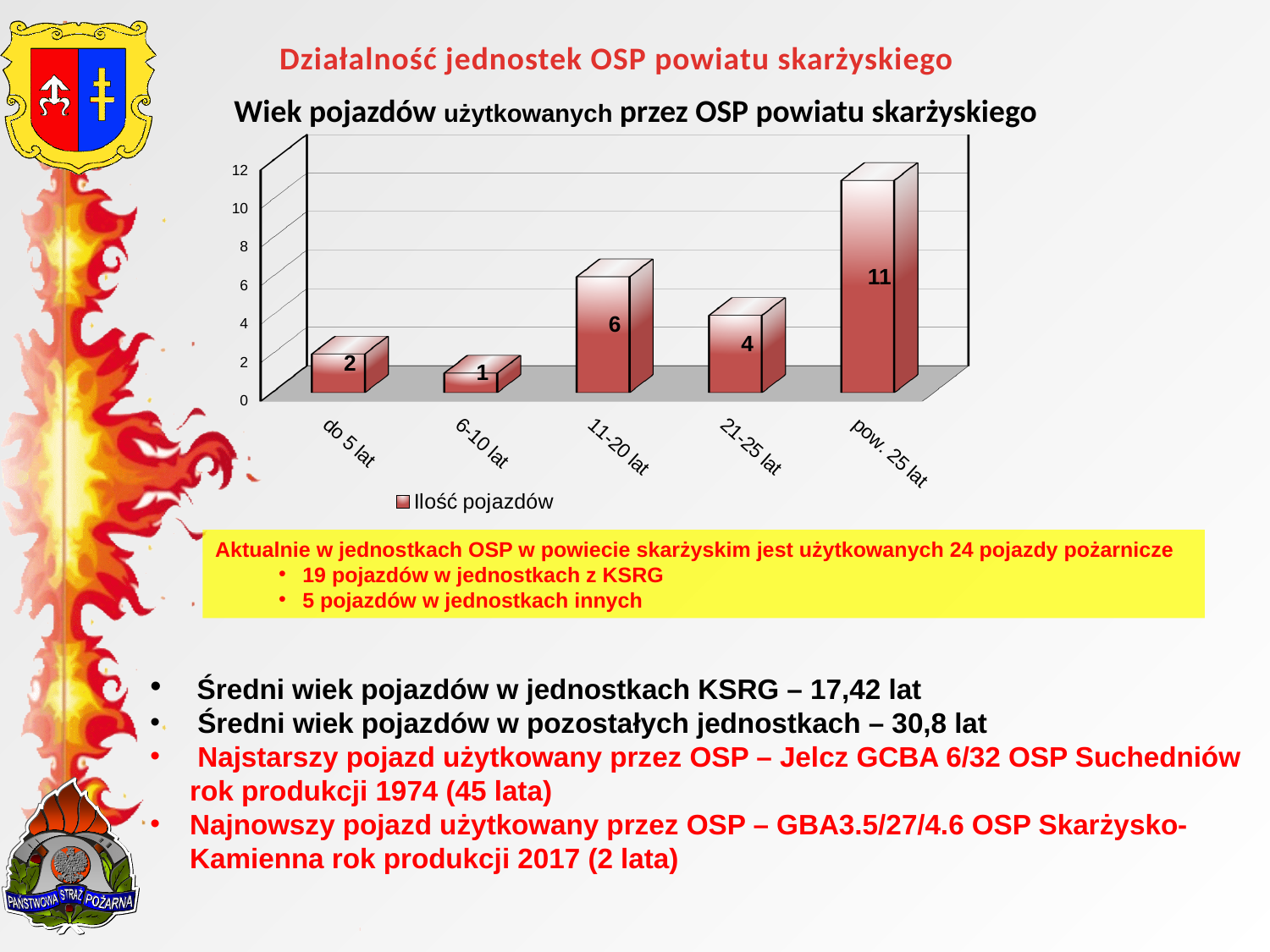
What is the difference between the values for 'pow. 25 lat' and '11-20 lat'? 5 What is the legend entry of the chart? Ilość pojazdów What is the value for the '11-20 lat' category? 6 Is the value for 'pow. 25 lat' greater or less than 10? greater How many series does the legend list? 1 Which age category has the lowest number of vehicles? 6-10 lat Which is larger, the value for '21-25 lat' or the value for '6-10 lat'? 21-25 lat How many age categories are shown on the x axis? 5 What kind of chart is shown on the slide? bar chart What is the value for the 'do 5 lat' category? 2 How many vehicles are in the 'pow. 25 lat' category? 11 Which age category has the highest number of vehicles? pow. 25 lat